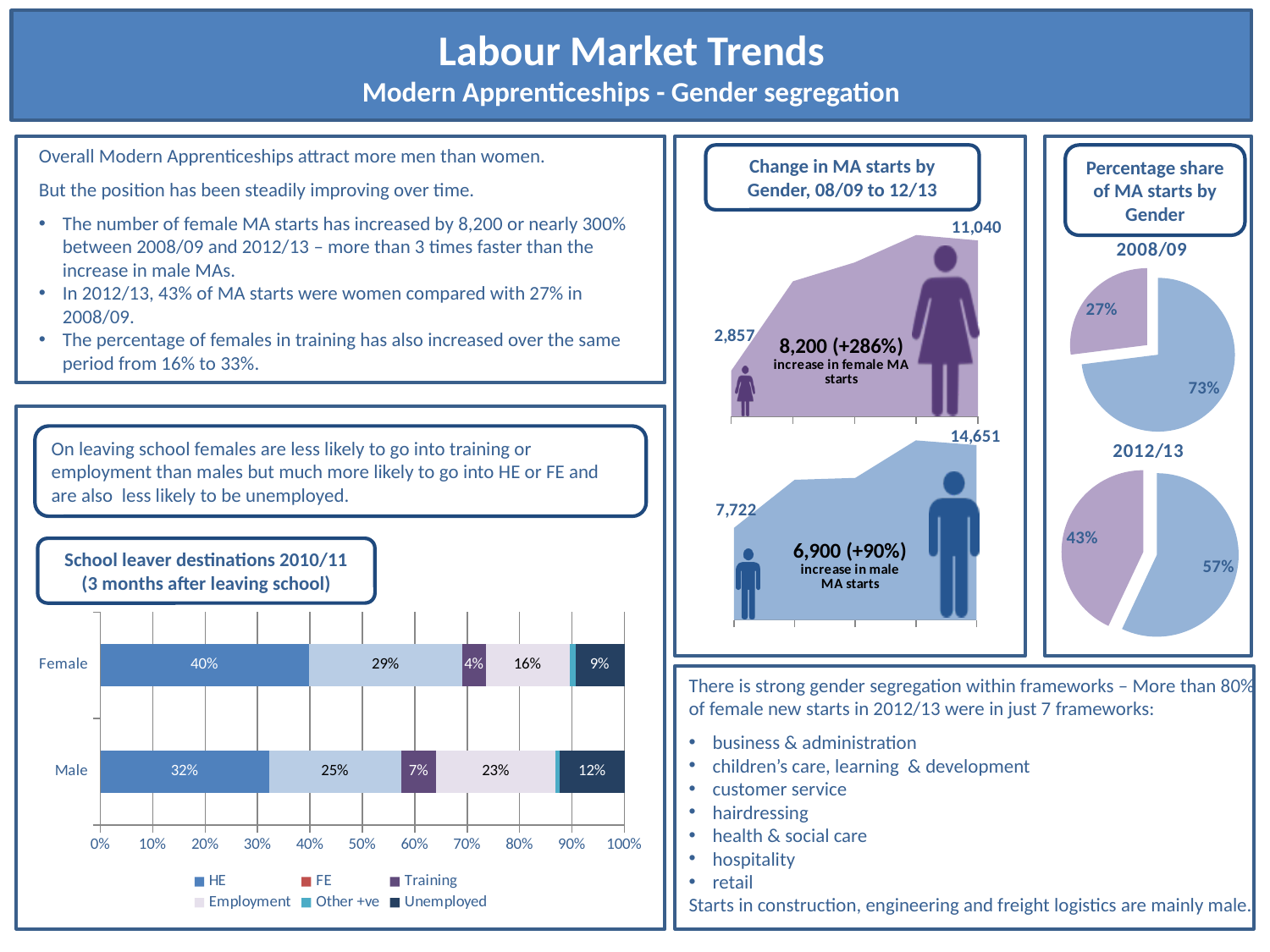
In the Change in MA starts by Gender chart, what was the number of male MA starts in 08/09? 7,722 What kind of chart is the School leaver destinations 2010/11 chart? Stacked bar chart In the School leaver destinations 2010/11 chart, which group has the larger FE percentage, Female or Male? Female In the School leaver destinations 2010/11 chart, what percentage of female school leavers went into HE? 40% In the School leaver destinations 2010/11 chart, how many series does the legend list? 6 In the School leaver destinations 2010/11 chart, what is the Training percentage for males? 7% In the Change in MA starts by Gender chart, what is the increase in male MA starts shown? 6,900 (+90%) In the Change in MA starts by Gender chart, what was the number of female MA starts in 12/13? 11,040 In the Percentage share of MA starts by Gender chart for 2012/13, what share is shown for the larger slice? 57% In the Percentage share of MA starts by Gender chart for 2008/09, what share is shown for the smaller slice? 27% In the School leaver destinations 2010/11 chart, what is the difference between the Unemployed percentages for males and females? 3% In the School leaver destinations 2010/11 chart, what percentage of male school leavers were in Employment? 23%